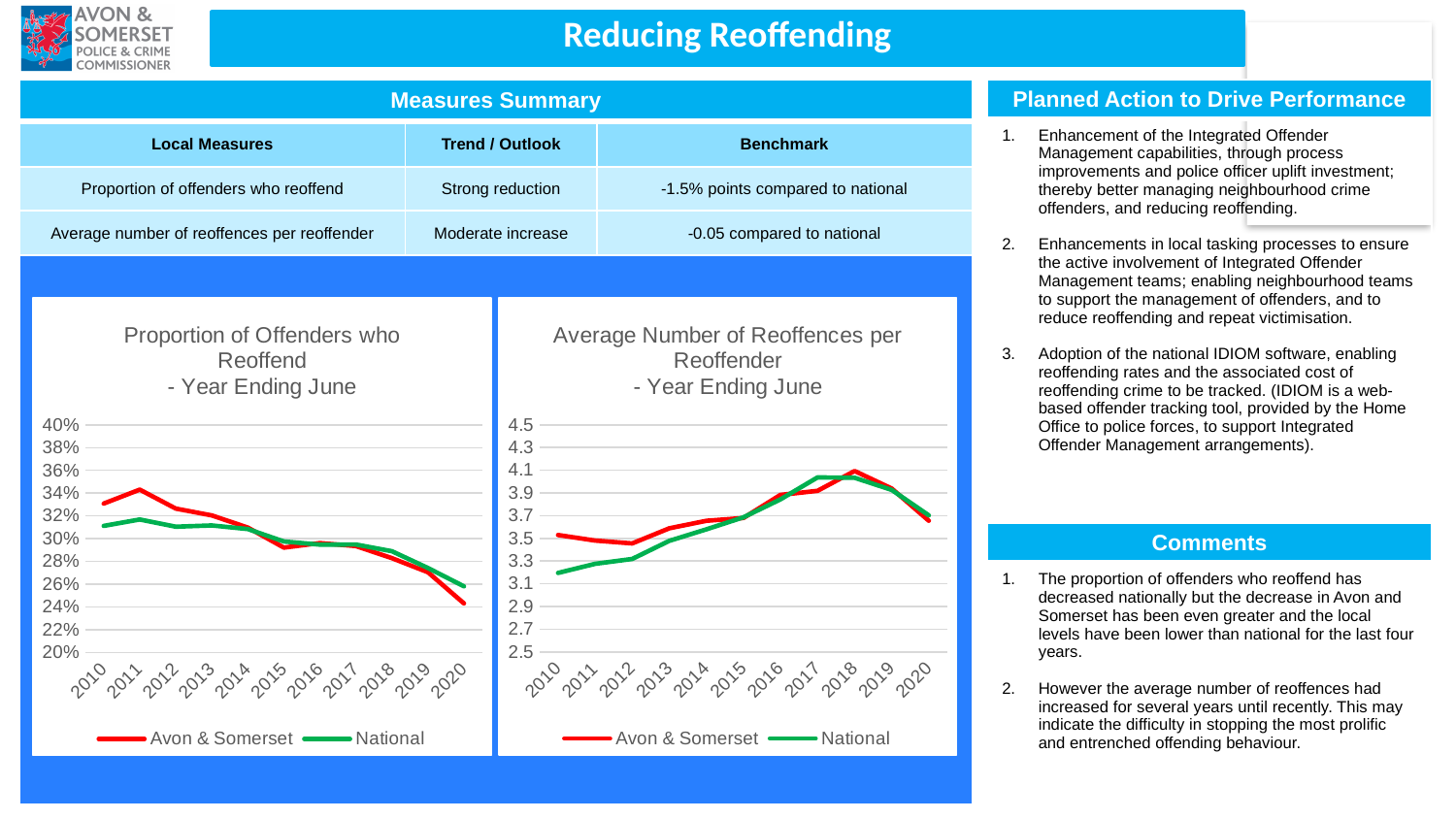
What kind of chart is the 'Proportion of Offenders who Reoffend - Year Ending June' chart? Line chart In the 'Proportion of Offenders who Reoffend' chart, is the Avon & Somerset value for 2011 greater or less than 32%? greater In the 'Proportion of Offenders who Reoffend' chart, is the Avon & Somerset value for 2020 greater or less than 26%? less In the 'Proportion of Offenders who Reoffend' chart, which series has the higher value in 2011, Avon & Somerset or National? Avon & Somerset In the 'Average Number of Reoffences per Reoffender' chart, which series has the higher value in 2010, Avon & Somerset or National? Avon & Somerset How many years are plotted along the x axis of the 'Proportion of Offenders who Reoffend' chart? 11 In the 'Average Number of Reoffences per Reoffender' chart, is the Avon & Somerset value for 2018 greater or less than 3.9? greater In the 'Proportion of Offenders who Reoffend' chart, do the Avon & Somerset values generally rise or fall from 2010 to 2020? Fall What colour is the National series line in the 'Average Number of Reoffences per Reoffender' chart? Green How many series does the legend of the 'Average Number of Reoffences per Reoffender' chart list? 2